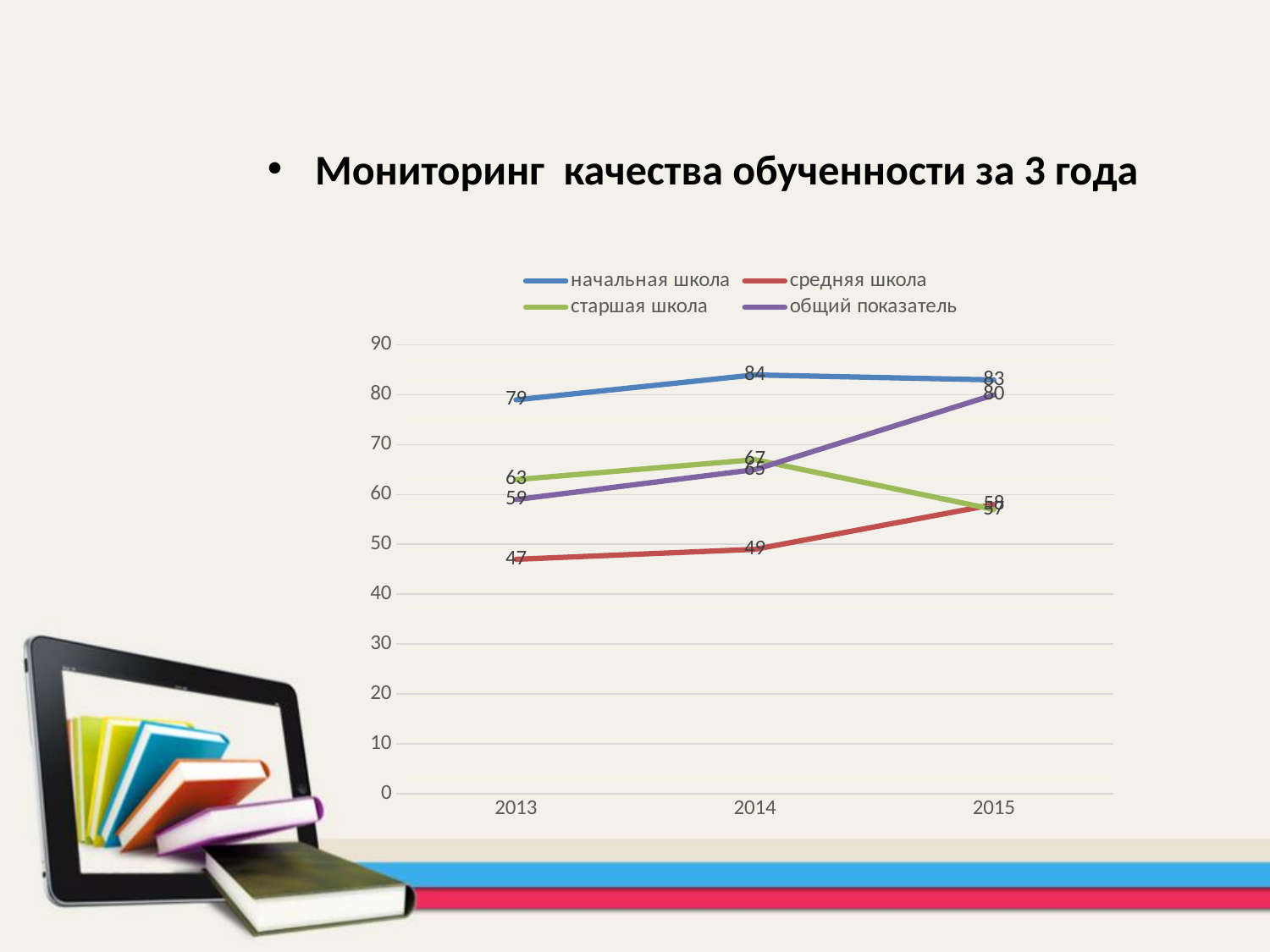
How many years are plotted along the x axis? 3 What is the value for старшая школа in 2014? 67 What is the value for общий показатель in 2015? 80 By how much did общий показатель increase from 2013 to 2015? 21 What kind of chart is shown on the slide? line chart What is the value for начальная школа in 2014? 84 How many series does the legend list? 4 Does the value for общий показатель rise or fall from 2013 to 2015? rise What is the value for средняя школа in 2013? 47 Is the value for средняя школа in 2014 greater or less than 50? less In which year is the value for начальная школа highest? 2014 In 2013, which is larger: старшая школа or общий показатель? старшая школа